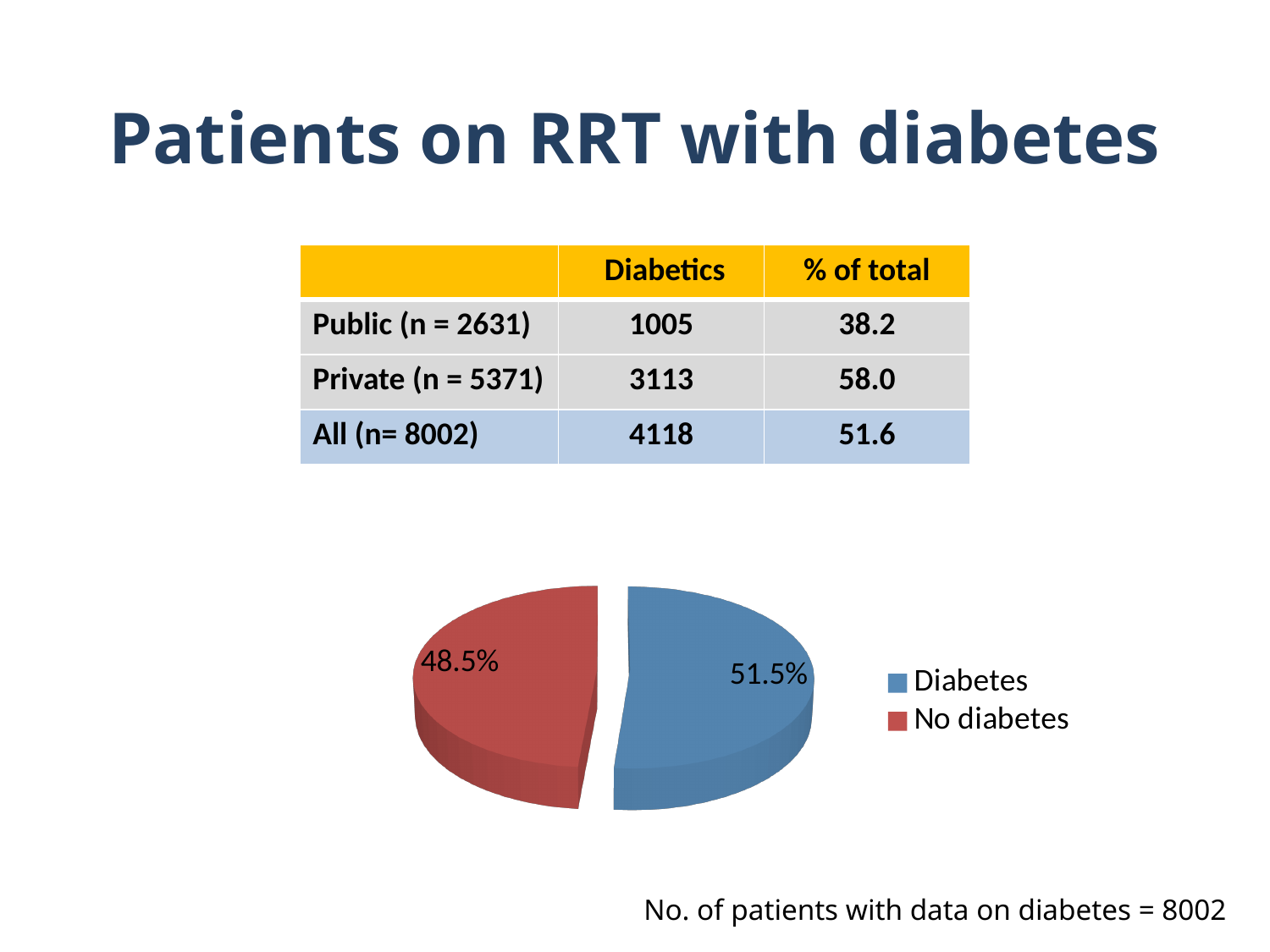
What share of the pie does the No diabetes slice represent? 48.5% What colour is the No diabetes slice in the pie chart? red Is the share of the Diabetes slice greater or less than 50%? greater What share of the pie does the Diabetes slice represent? 51.5% Which is larger in the pie chart, the Diabetes slice or the No diabetes slice? Diabetes What is the difference in percentage points between the Diabetes and No diabetes slices? 3.0 How many slices does the pie chart have? 2 Which slice of the pie chart is the smallest? No diabetes What colour is the Diabetes slice in the pie chart? blue What kind of chart is shown on the slide? pie chart Which slice of the pie chart is the largest? Diabetes How many entries does the pie chart's legend list? 2